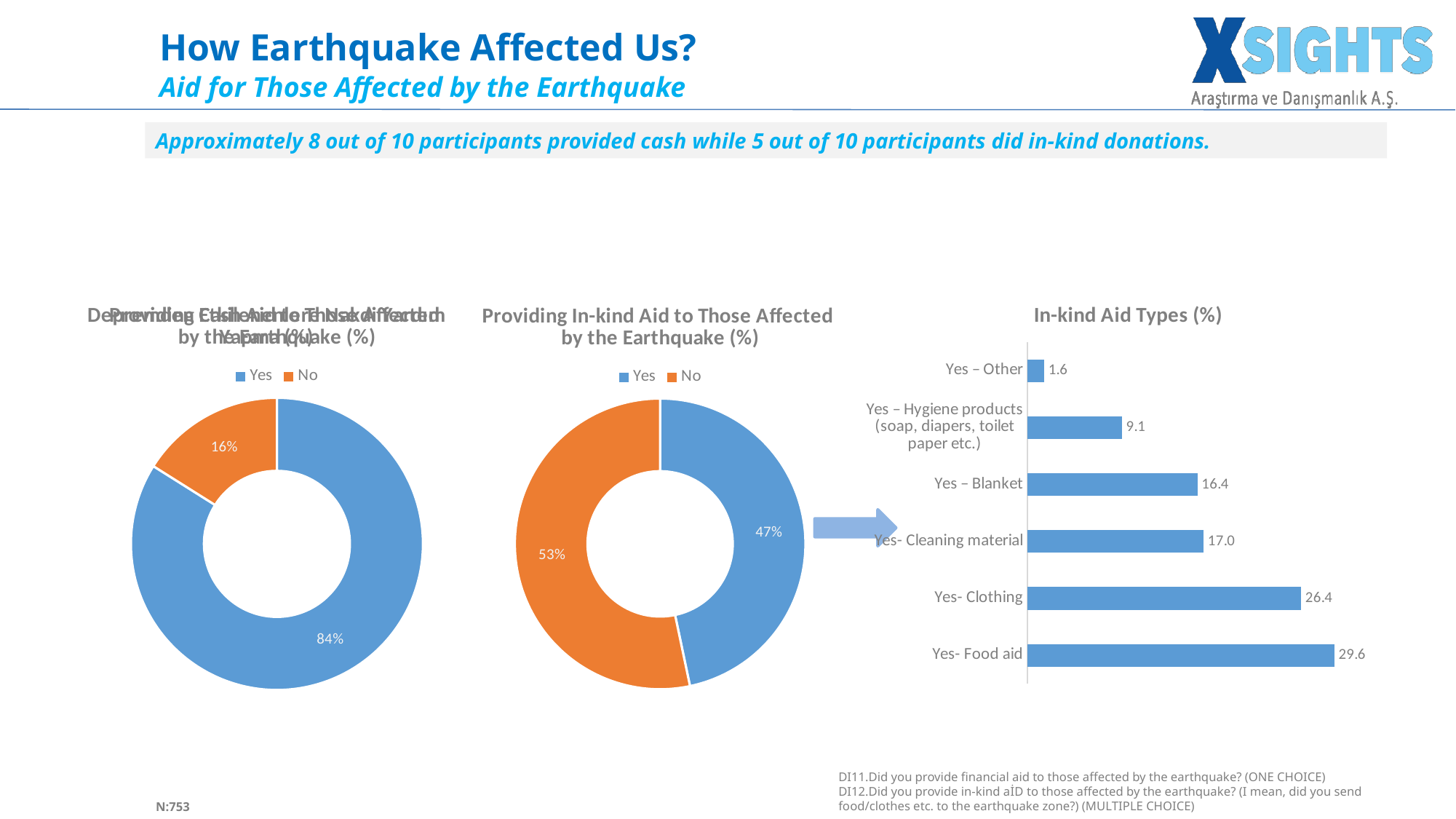
In the 'Providing In-kind Aid to Those Affected by the Earthquake (%)' chart, which is larger, Yes or No? No What type of chart is 'In-kind Aid Types (%)'? Bar chart In the 'In-kind Aid Types (%)' chart, what is the value for Yes- Food aid? 29.6 In the 'In-kind Aid Types (%)' chart, which aid type has the lowest value? Yes – Other In the left donut chart, what percentage of participants answered No? 16% In the 'In-kind Aid Types (%)' chart, what is the difference between Yes- Clothing and Yes – Blanket? 10.0 In the 'In-kind Aid Types (%)' chart, what is the value for Yes – Hygiene products (soap, diapers, toilet paper etc.)? 9.1 In the left donut chart, what percentage of participants answered Yes? 84% In the 'Providing In-kind Aid to Those Affected by the Earthquake (%)' chart, what is the difference between the No and Yes shares? 6% In the 'Providing In-kind Aid to Those Affected by the Earthquake (%)' chart, what percentage answered Yes? 47% In the 'In-kind Aid Types (%)' chart, which aid type has the highest value? Yes- Food aid How many categories are shown in the 'In-kind Aid Types (%)' chart? 6